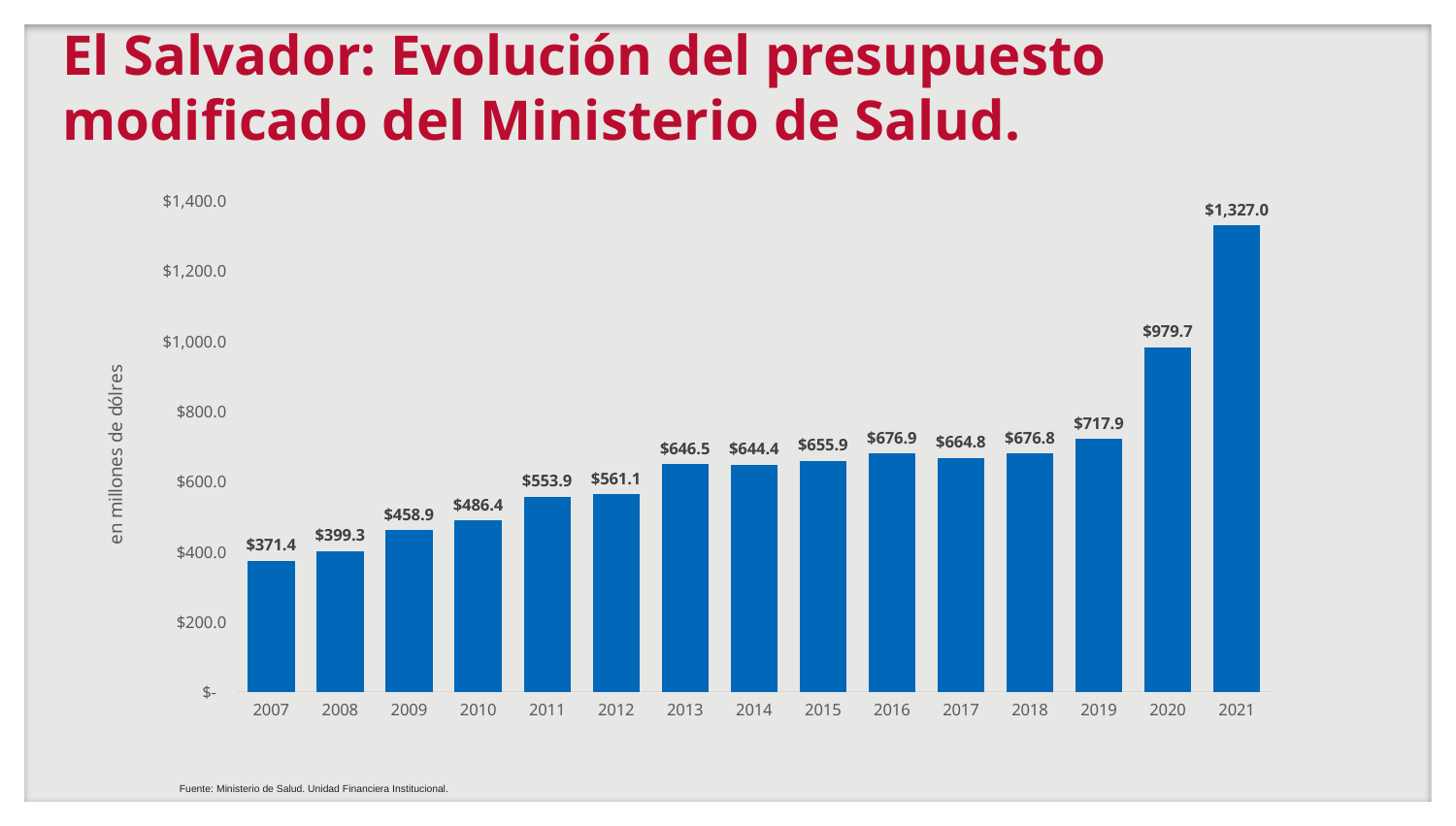
What is the value for 2021? $1,327.0 What is the label of the vertical axis? en millones de dólres Which is larger, the value for 2020 or the value for 2019? 2020 How many years are shown on the x axis? 15 What is the value for 2007? $371.4 What is the value for 2014? $644.4 Which year has the highest value? 2021 What kind of chart is shown on the slide? Bar chart What is the difference between the values for 2021 and 2020? $347.3 Is the value for 2013 greater or less than $600.0? greater What is the difference between the values for 2019 and 2018? $41.1 Which year has the lowest value? 2007